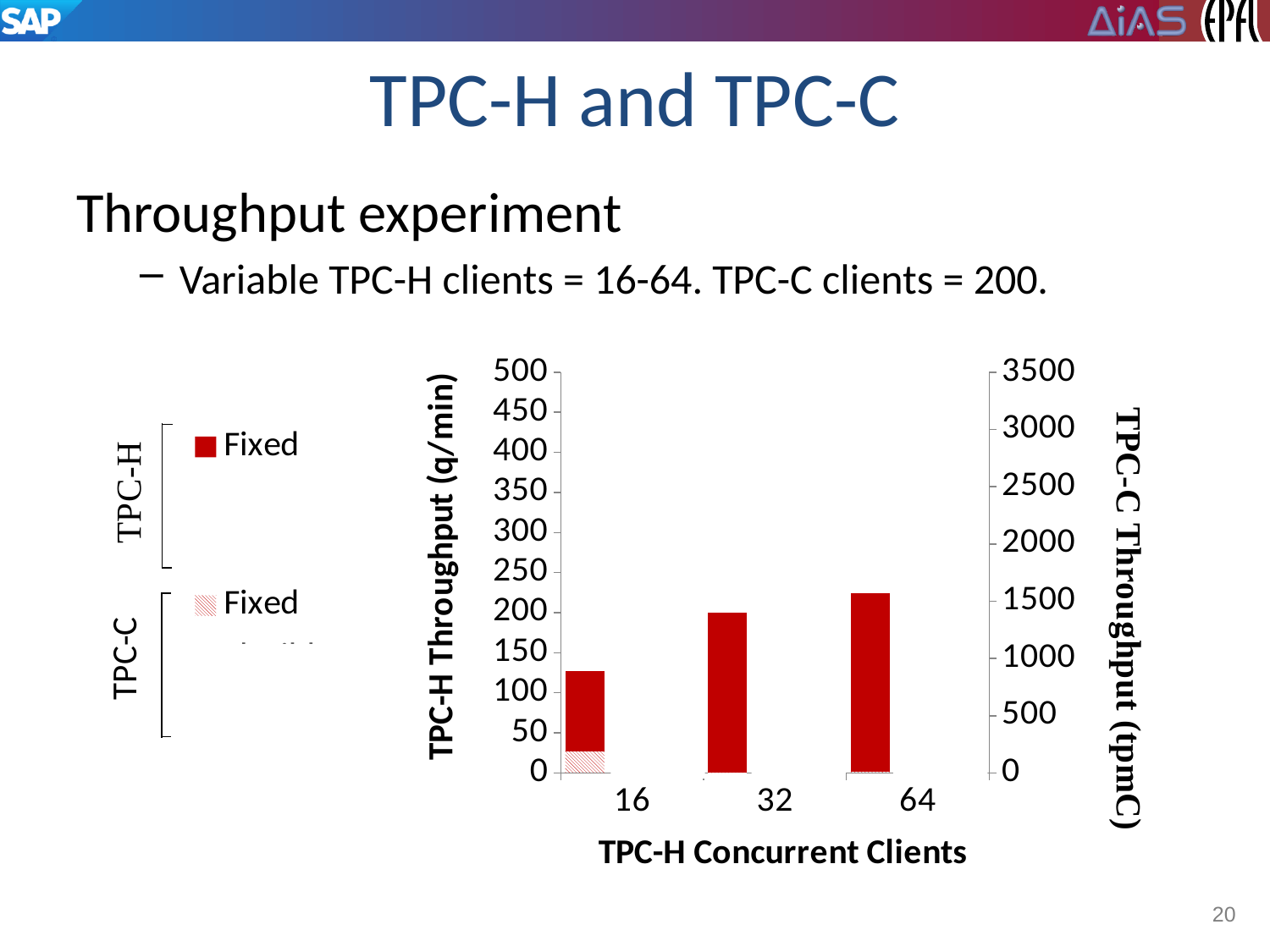
Is the TPC-H throughput for 32 concurrent clients greater or less than 150? greater What kind of chart is shown on the slide? bar chart Does the TPC-H throughput (red bars) rise or fall as the number of concurrent clients increases from 16 to 64? rise Is the TPC-H throughput for 16 concurrent clients greater or less than 100? greater Which number of concurrent clients has the highest TPC-H throughput (red bar)? 64 What is the title of the left vertical axis? TPC-H Throughput (q/min) Is the TPC-H throughput for 16 concurrent clients greater or less than 150? less How many TPC-H concurrent client settings are shown on the x axis? 3 Which has a higher TPC-H throughput, 16 or 32 concurrent clients? 32 What is the title of the x axis? TPC-H Concurrent Clients Which number of concurrent clients has the lowest TPC-H throughput (red bar)? 16